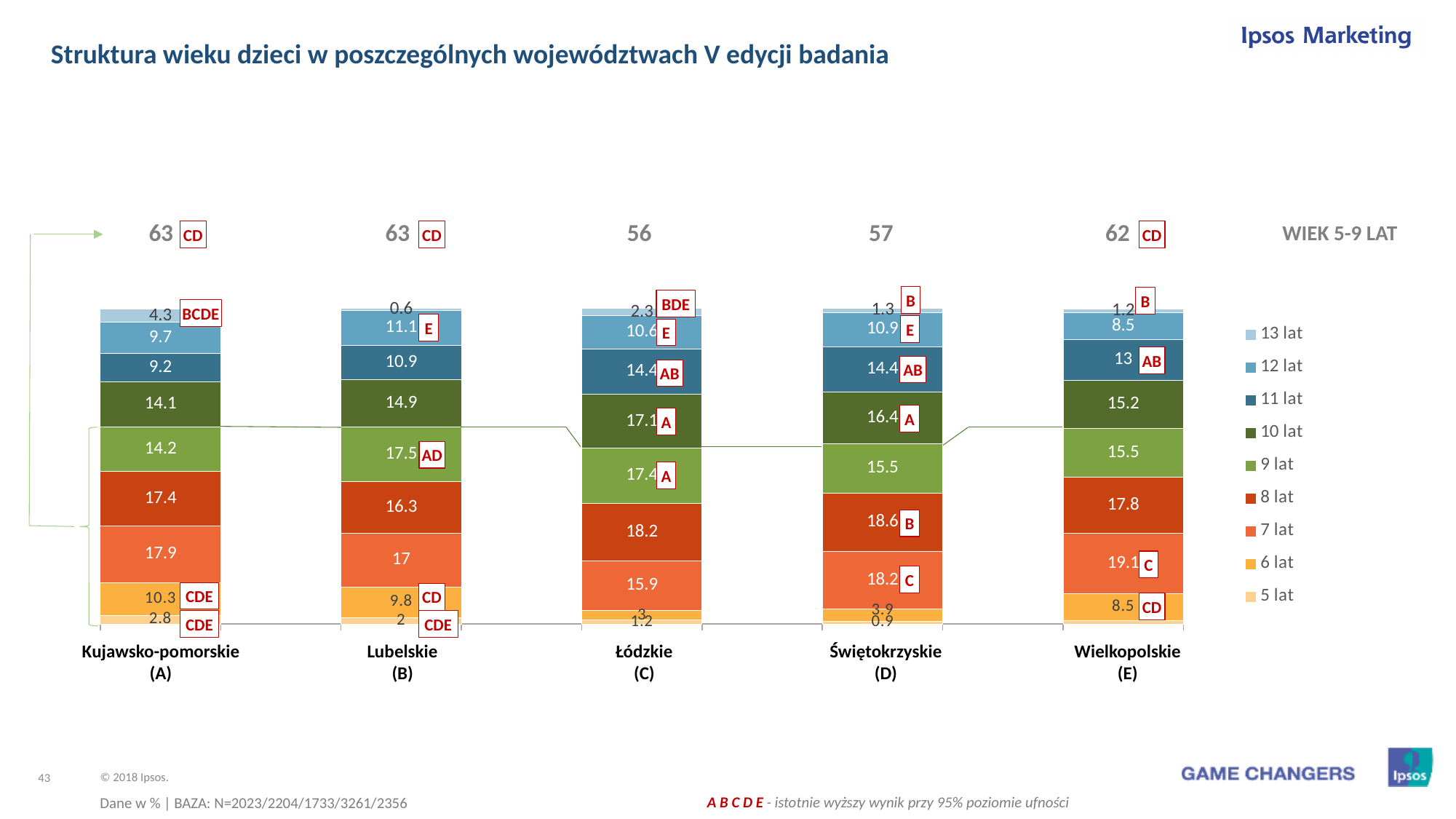
What is the value for 9 lat in Lubelskie (B)? 17.5 Which voivodeship has the highest value for 6 lat? Kujawsko-pomorskie (A) How many voivodeships are shown on the x axis? 5 What kind of chart is shown on the slide? Stacked bar chart How many series does the legend list? 9 What is the value for 8 lat in Świętokrzyskie (D)? 18.6 Which voivodeship has the lowest value for 13 lat? Lubelskie (B) What is the WIEK 5-9 LAT value shown above the Łódzkie (C) bar? 56 What is the value for 13 lat in Kujawsko-pomorskie (A)? 4.3 What is the difference between the 11 lat values for Łódzkie (C) and Kujawsko-pomorskie (A)? 5.2 What is the value for 7 lat in Wielkopolskie (E)? 19.1 Which is larger: the 10 lat value for Łódzkie (C) or for Wielkopolskie (E)? Łódzkie (C)